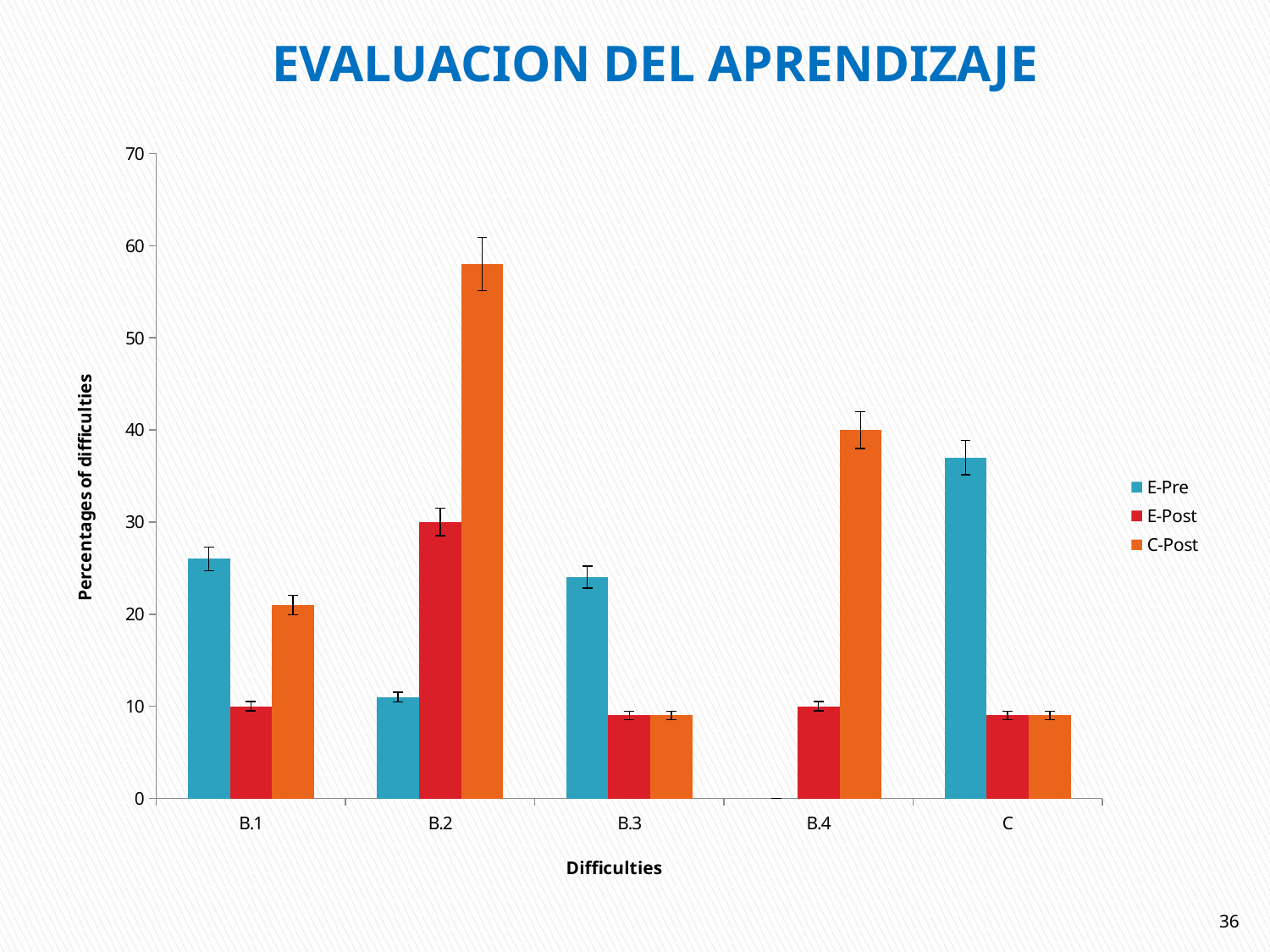
Is the E-Pre value for C greater or less than 30? greater Which is larger, the C-Post value for B.2 or the C-Post value for B.4? B.2 Which category has the lowest E-Pre value? B.4 How many categories are shown on the x axis? 5 What is the title of the y axis? Percentages of difficulties What is the title of the x axis? Difficulties How many series does the legend list? 3 Which is larger for B.1, the E-Pre value or the E-Post value? E-Pre Which category has the highest C-Post value? B.2 Is the E-Pre value for B.2 greater or less than 20? less Is the C-Post value for B.2 greater or less than 50? greater What kind of chart is shown on the slide? bar chart